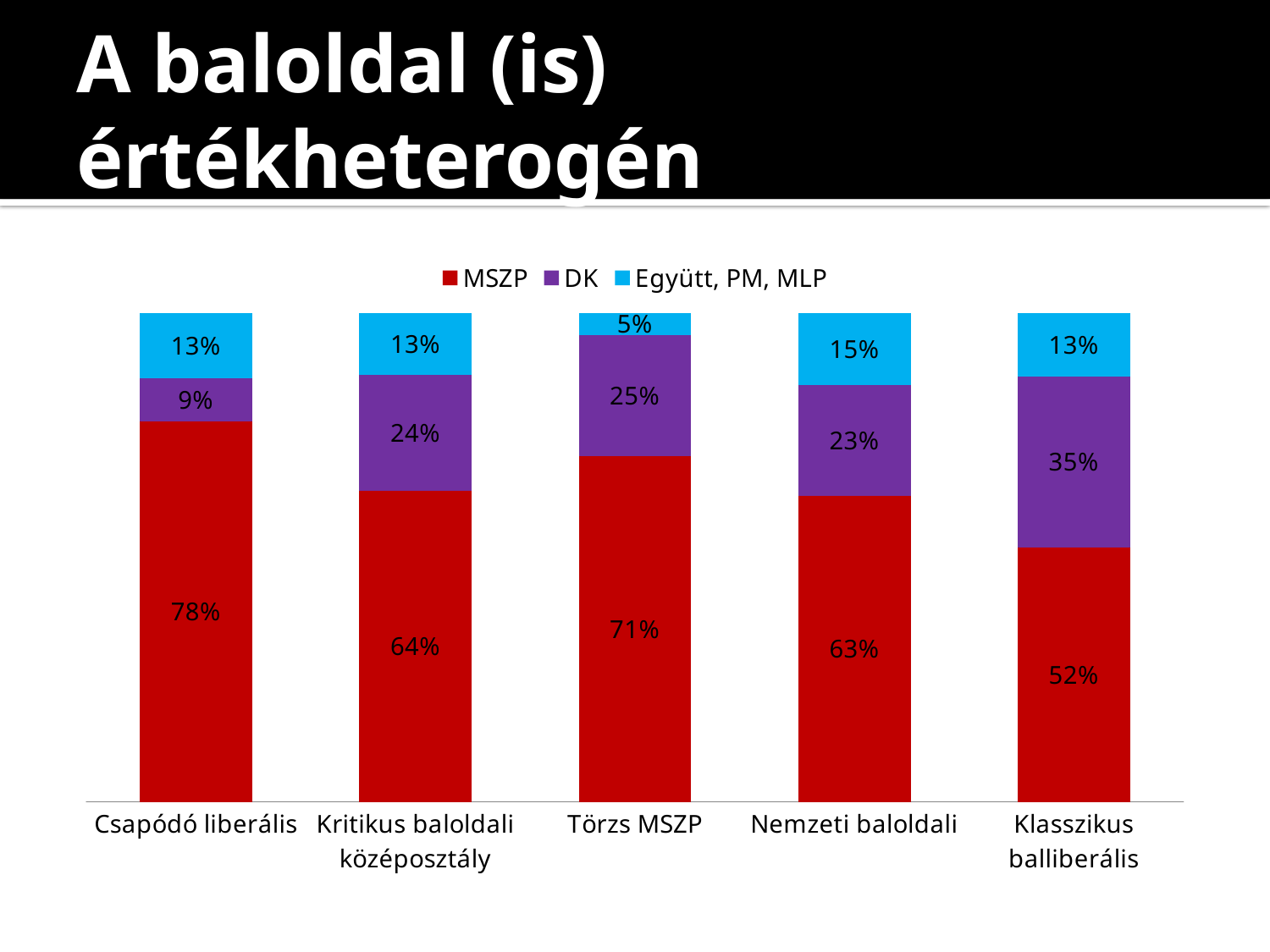
Which is larger, the DK value for Törzs MSZP or the DK value for Kritikus baloldali középosztály? Törzs MSZP What is the difference between the MSZP values for Csapódó liberális and Klasszikus balliberális? 26% How many categories are shown on the x axis? 5 Which category has the highest MSZP value? Csapódó liberális Which category has the lowest DK value? Csapódó liberális What kind of chart is shown on the slide? stacked bar chart What is the MSZP value for Csapódó liberális? 78% What is the Együtt, PM, MLP value for Törzs MSZP? 5% How many series does the legend list? 3 Which series is shown in red? MSZP What is the DK value for Nemzeti baloldali? 23% What is the DK value for Klasszikus balliberális? 35%